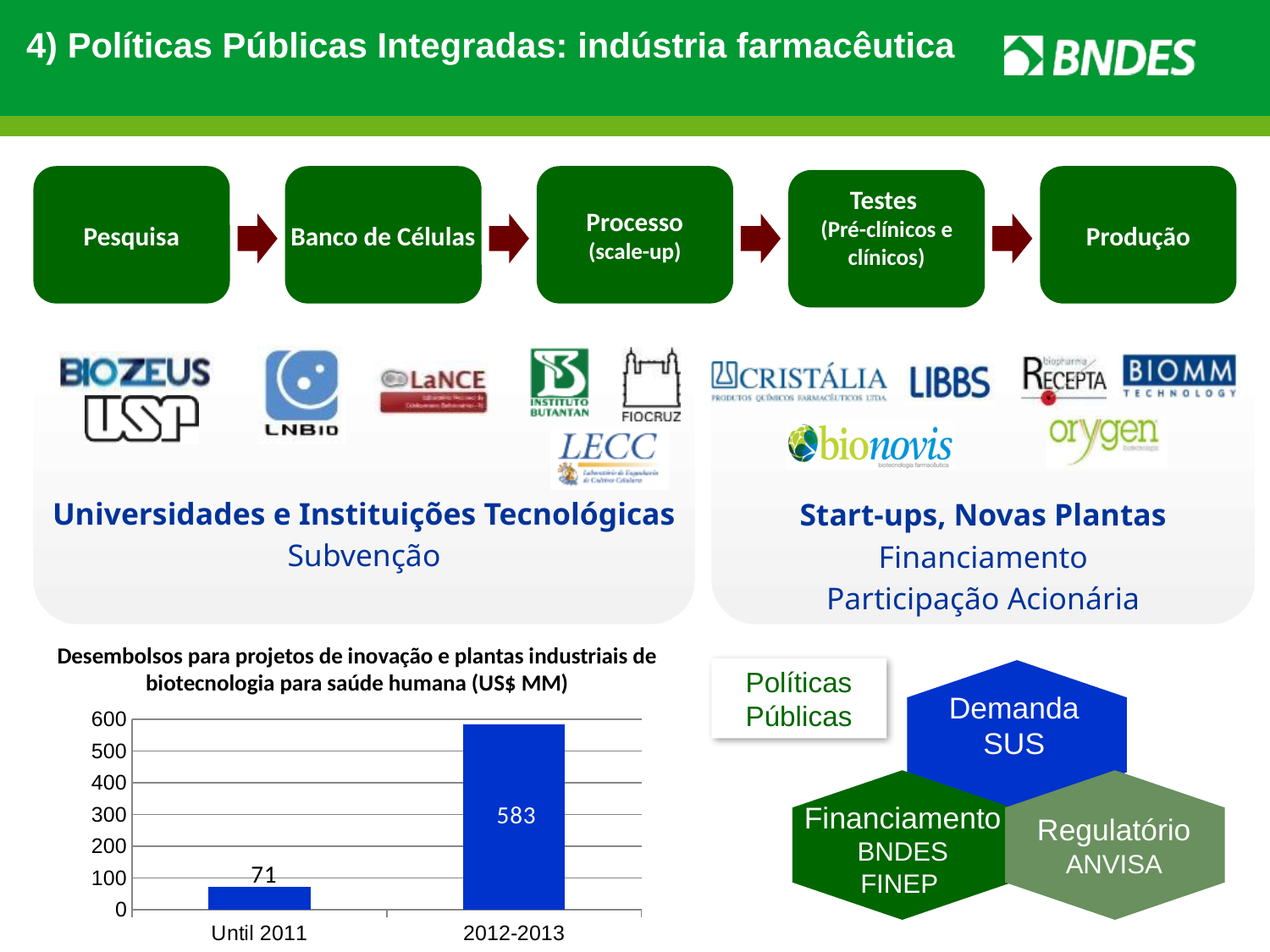
How many categories are shown on the x axis of the chart? 2 What is the value for 'Until 2011' in the chart? 71 Which is larger, the value for 'Until 2011' or the value for '2012-2013'? 2012-2013 Which category has the highest value in the chart? 2012-2013 What is the difference between the values for '2012-2013' and 'Until 2011'? 512 What is the value for '2012-2013' in the chart? 583 What kind of chart is shown on the slide? bar chart Do the values rise or fall from 'Until 2011' to '2012-2013'? rise Is the value for 'Until 2011' greater or less than 100? less What unit is given in the chart title for the disbursement values? US$ MM Which category has the lowest value in the chart? Until 2011 Is the value for '2012-2013' greater or less than 500? greater